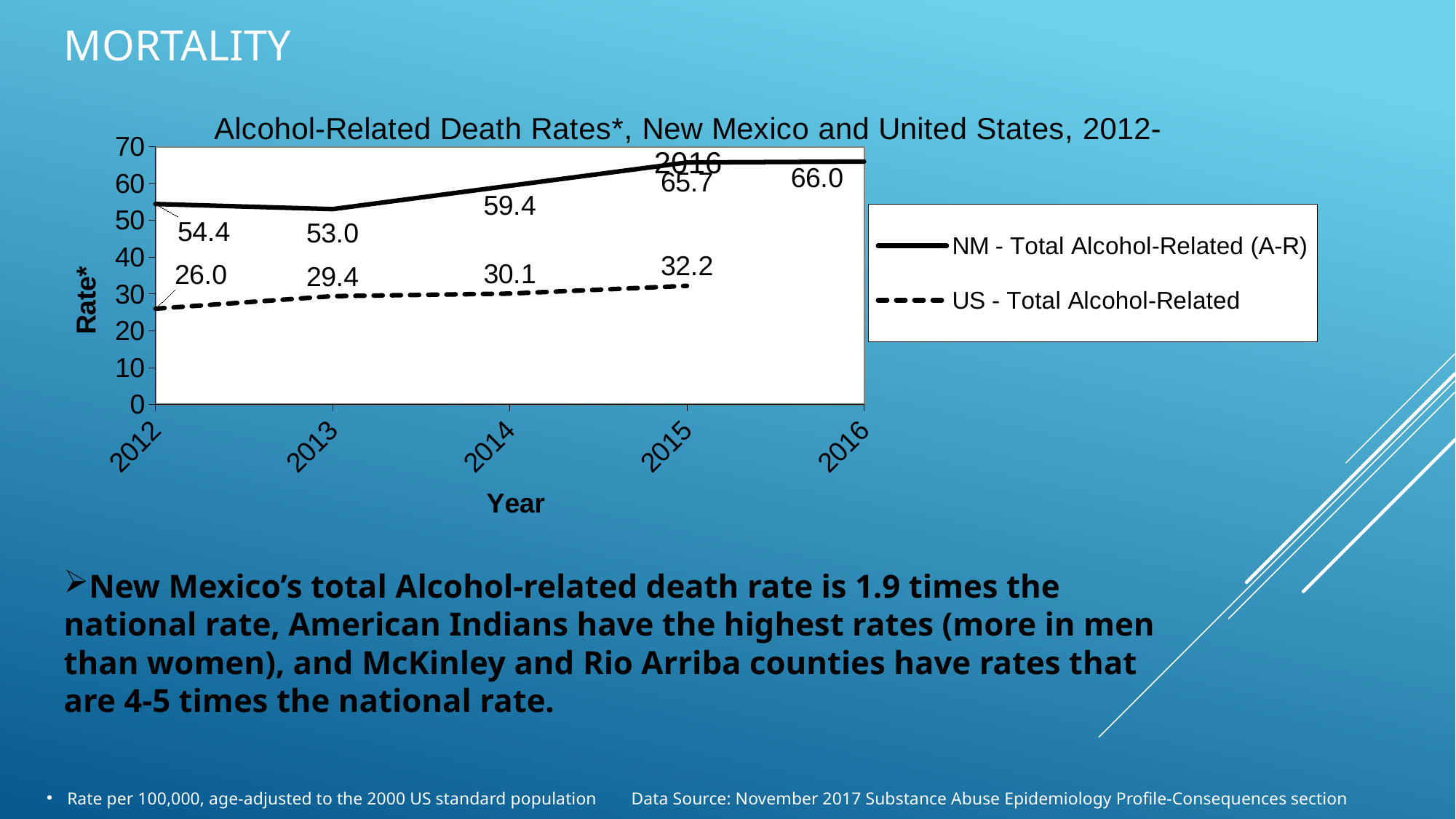
In which year is the NM - Total Alcohol-Related (A-R) rate lowest? 2013 How many series does the legend list? 2 In which year is the US - Total Alcohol-Related rate highest? 2015 What type of chart is shown on the slide? Line chart How many years are shown on the x axis? 5 What is the US - Total Alcohol-Related rate in 2013? 29.4 What is the NM - Total Alcohol-Related (A-R) rate in 2016? 66.0 Which is larger in 2012: the NM - Total Alcohol-Related (A-R) rate or the US - Total Alcohol-Related rate? NM - Total Alcohol-Related (A-R) What is the title of the chart? Alcohol-Related Death Rates*, New Mexico and United States, 2012-2016 What is the difference between the NM and US total alcohol-related rates in 2015? 33.5 Does the US - Total Alcohol-Related rate rise or fall from 2012 to 2015? Rise What is the NM - Total Alcohol-Related (A-R) rate in 2014? 59.4